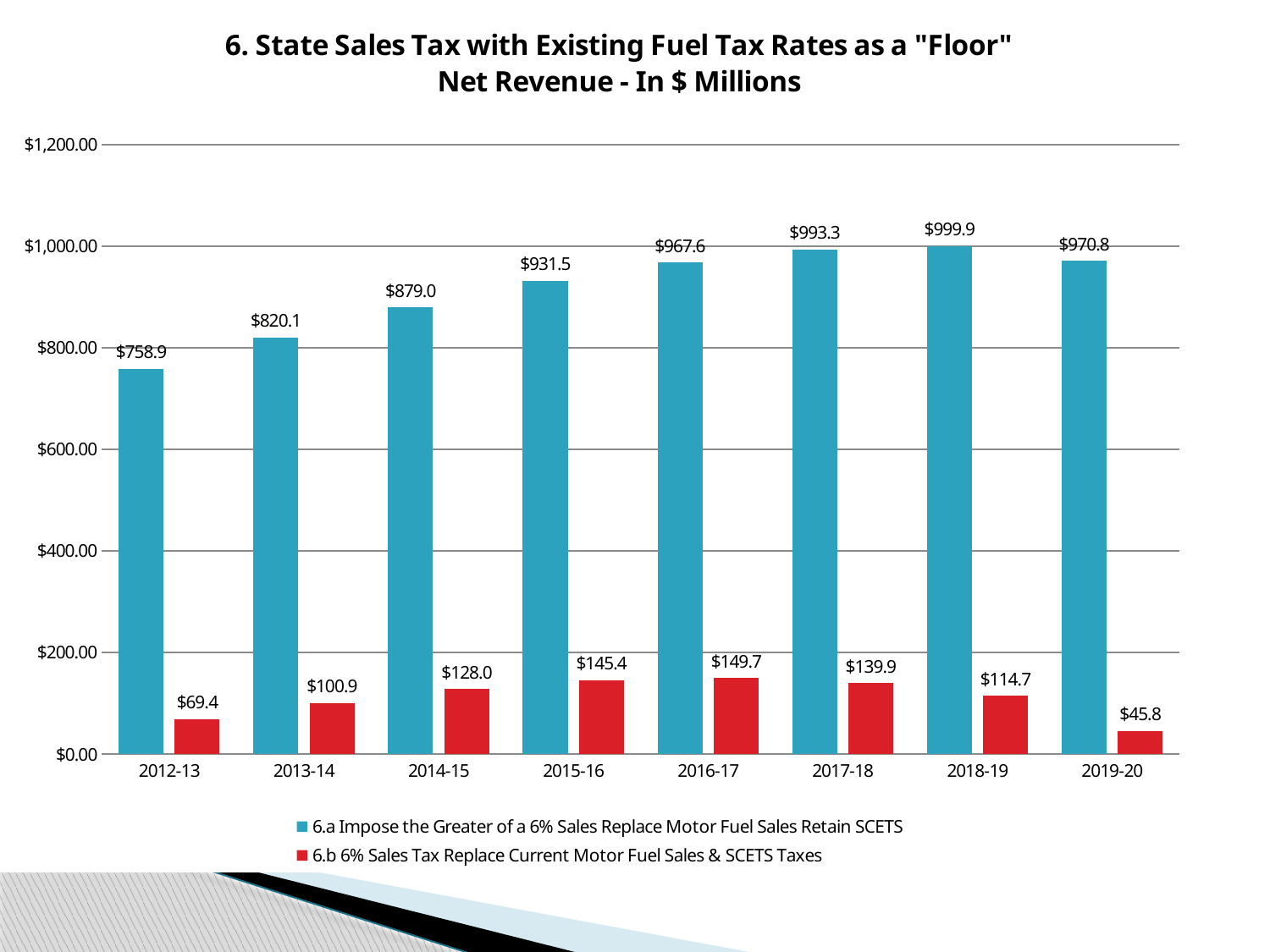
How many fiscal years are shown on the x axis? 8 Is the value for series 6.a in 2013-14 greater or less than $800.00? greater What is the difference between the 6.a and 6.b values in 2012-13? $689.5 What kind of chart is shown on the slide? bar chart In which year is the value for series 6.b lowest? 2019-20 What is the value for series 6.a in 2015-16? $931.5 In which year is the value for series 6.a highest? 2018-19 Does the value for series 6.a rise or fall from 2012-13 to 2018-19? rise What is the value for series 6.b in 2017-18? $139.9 What colour are the bars for series 6.b? red How many series does the legend list? 2 Which is larger for series 6.b: 2014-15 or 2018-19? 2014-15